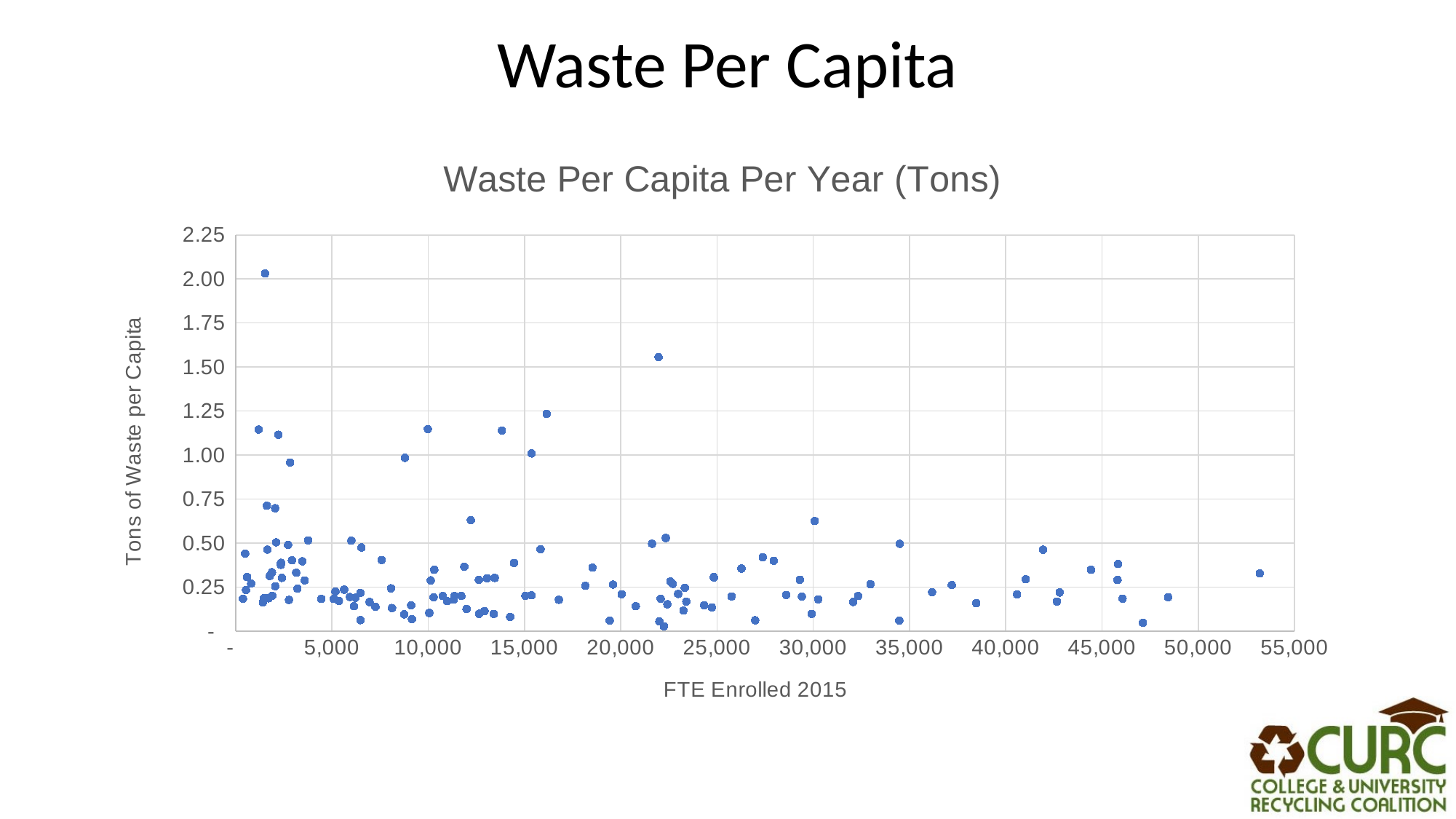
Is the highest point on the chart greater or less than 1.75 tons of waste per capita? greater Are most of the points on the chart above or below 0.50 tons of waste per capita? below What is the title of the chart? Waste Per Capita Per Year (Tons) Do the highest waste per capita values tend to occur at lower or higher FTE enrollment? lower How many data series are plotted on the chart? 1 Is the highest point on the chart located at an FTE enrollment greater or less than 5,000? less What is the label of the x axis of the chart? FTE Enrolled 2015 What kind of chart is shown on the slide? Scatter chart